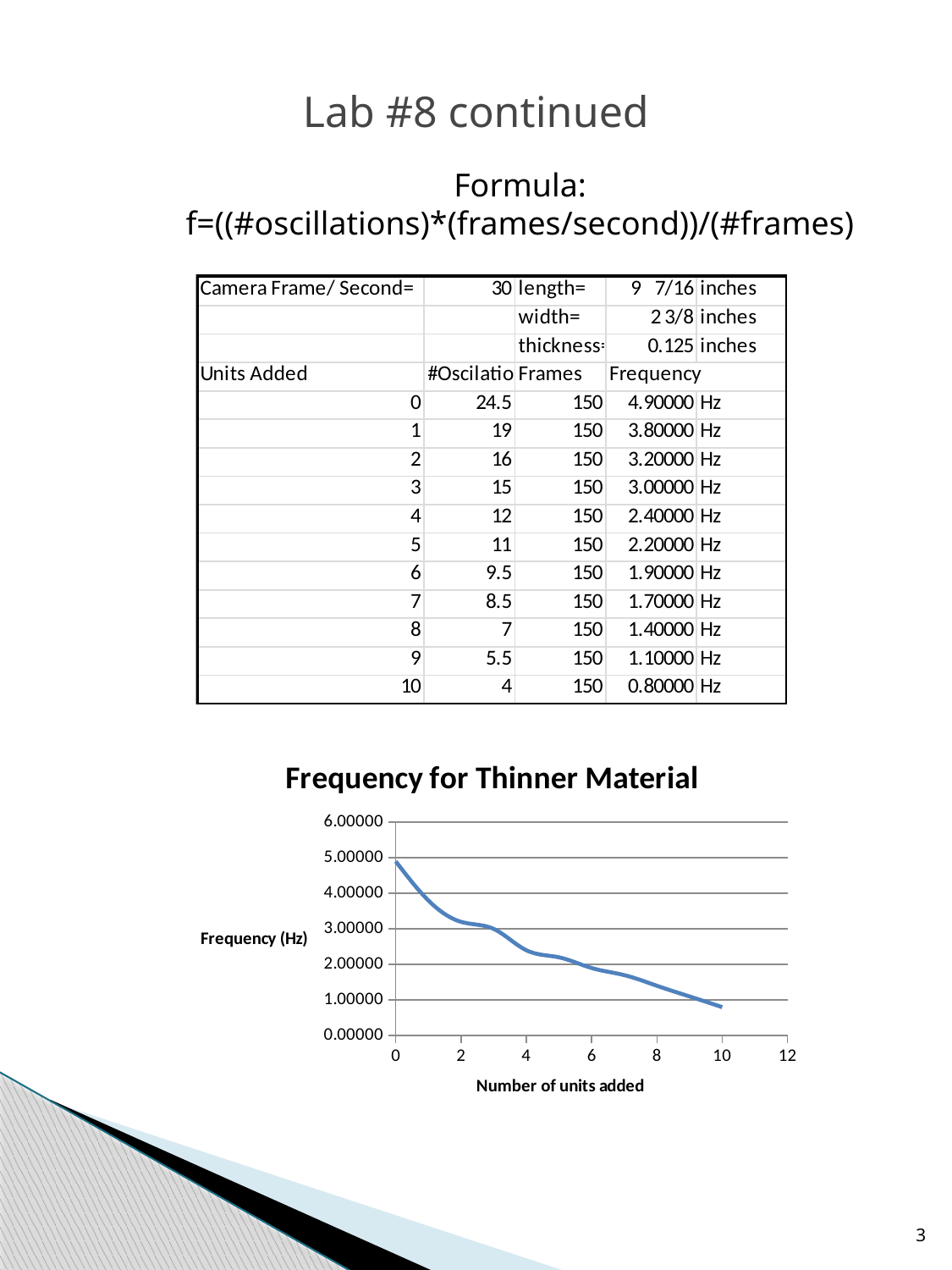
Is the frequency at 0 units added greater or less than 4.00000 Hz? greater What is the title of the chart on the slide? Frequency for Thinner Material At which number of units added is the frequency highest in the chart? 0 Is the frequency at 4 units added greater or less than 2.00000 Hz? greater Is the frequency at 8 units added greater or less than 2.00000 Hz? less At which number of units added is the frequency lowest in the chart? 10 In the chart, does the frequency rise or fall as the number of units added increases? fall Which has the higher frequency in the chart: 2 units added or 8 units added? 2 units added What is the label of the x axis of the chart? Number of units added How many data points are plotted in the chart? 11 What type of chart is shown under the title "Frequency for Thinner Material"? line chart